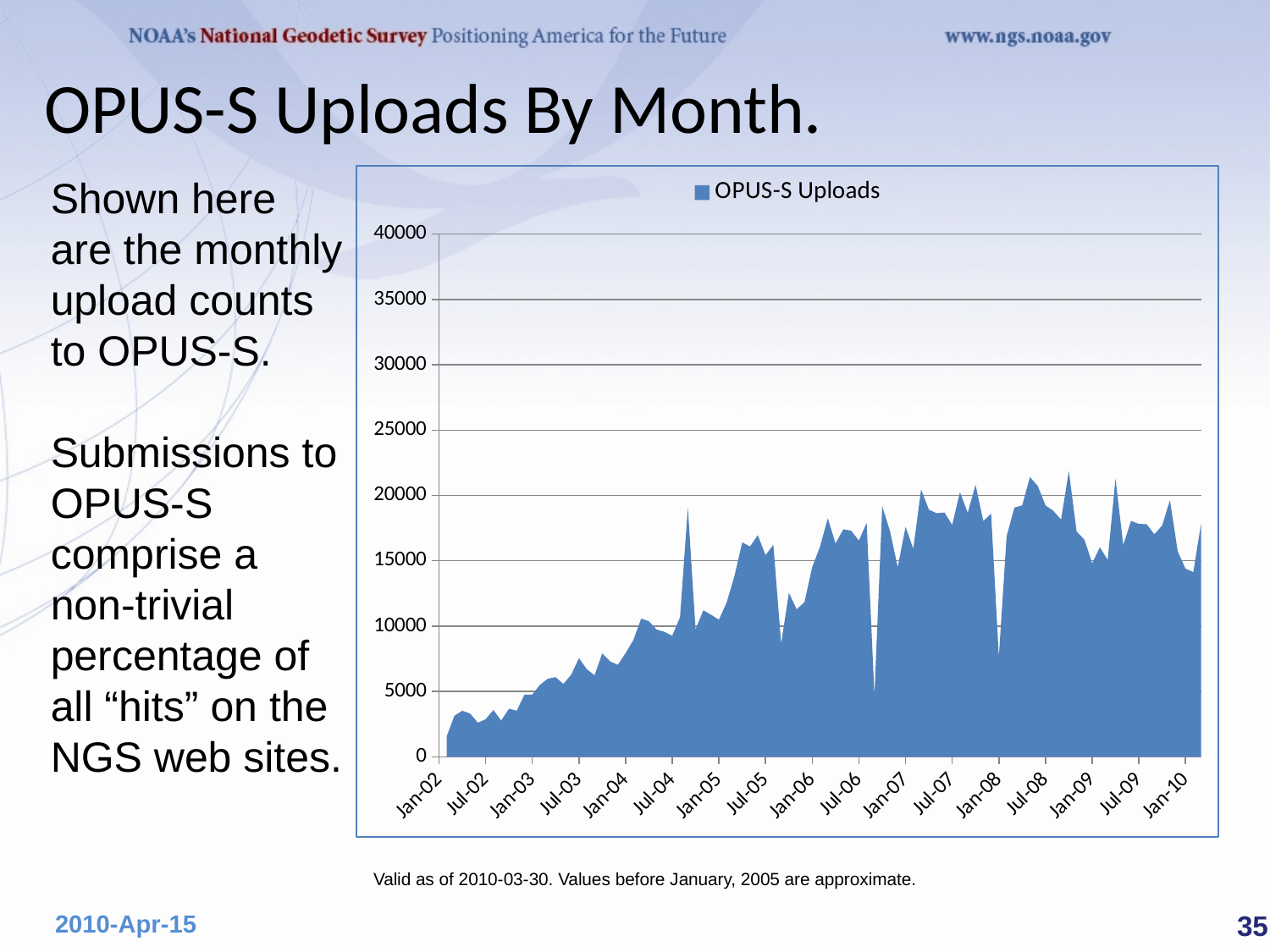
What is the highest value shown on the vertical axis? 40000 What kind of chart is shown on the slide? Area chart Which is larger, the value for Jan-02 or the value for Jan-10? Jan-10 Is the value for Jul-03 greater or less than 5000? greater Which is larger, the value for Jan-03 or the value for Jan-07? Jan-07 What is the name of the series shown in the chart legend? OPUS-S Uploads Is the value for Jan-10 greater or less than 15000? less How many series does the chart legend list? 1 Is the value for Jan-02 greater or less than 5000? less Overall, do the OPUS-S upload values rise or fall from Jan-02 to Jan-10? Rise